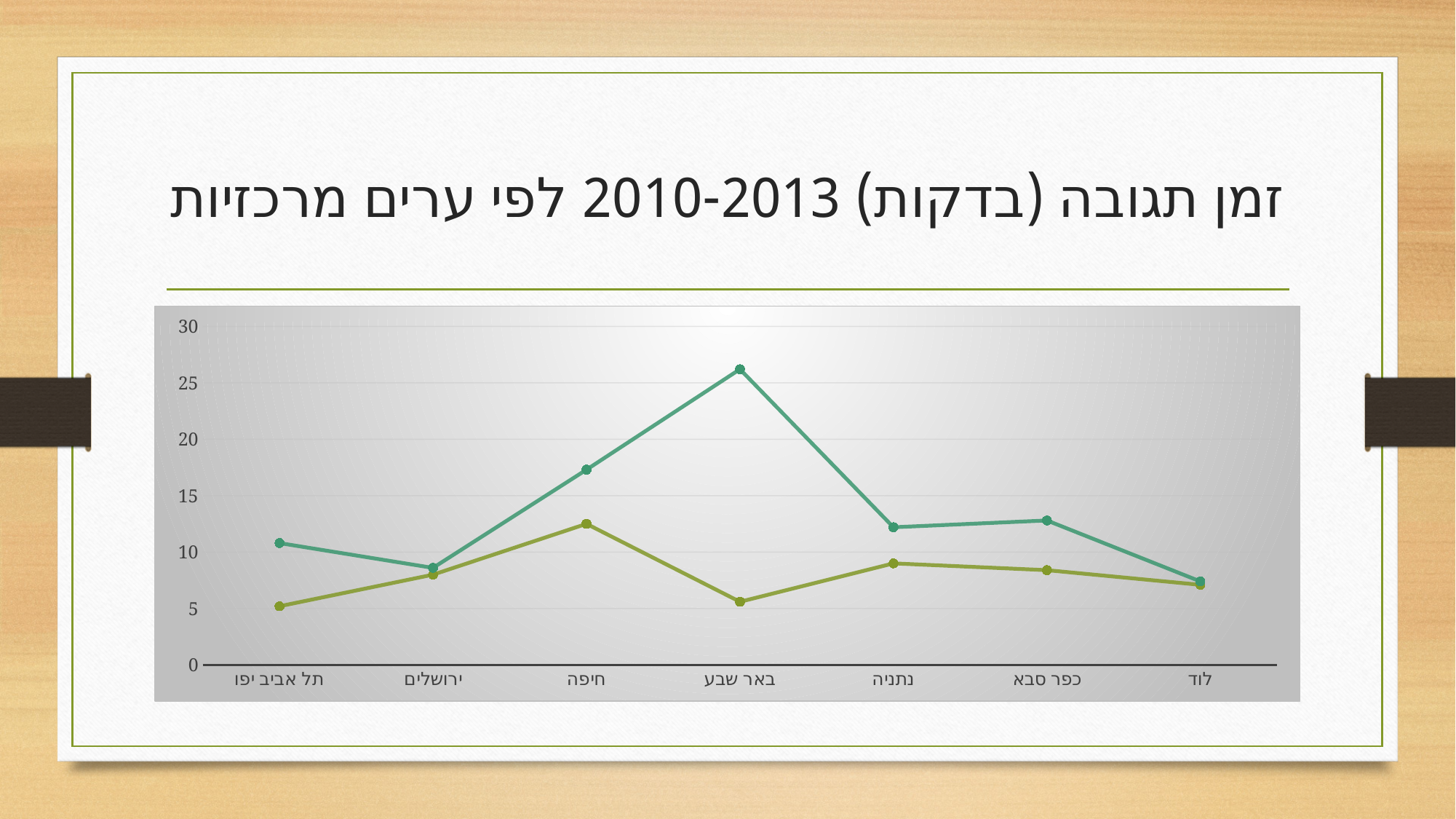
At באר שבע, which line has the larger value, the teal line or the olive-green line? the teal line Is the teal line's value for באר שבע greater or less than 25? greater What is the title of the slide? זמן תגובה (בדקות) 2010-2013 לפי ערים מרכזיות Is the teal line's value for חיפה greater or less than 15? greater For the olive-green line, which city has the highest value? חיפה Does the olive-green line rise or fall from תל אביב יפו to חיפה? rise How many lines are plotted on the chart? 2 Is the olive-green line's value for באר שבע greater or less than 10? less What kind of chart is shown on the slide? line chart How many cities are shown on the x axis of the chart? 7 For the teal line, which city has the highest value? באר שבע For the teal line, which city has the lowest value? לוד